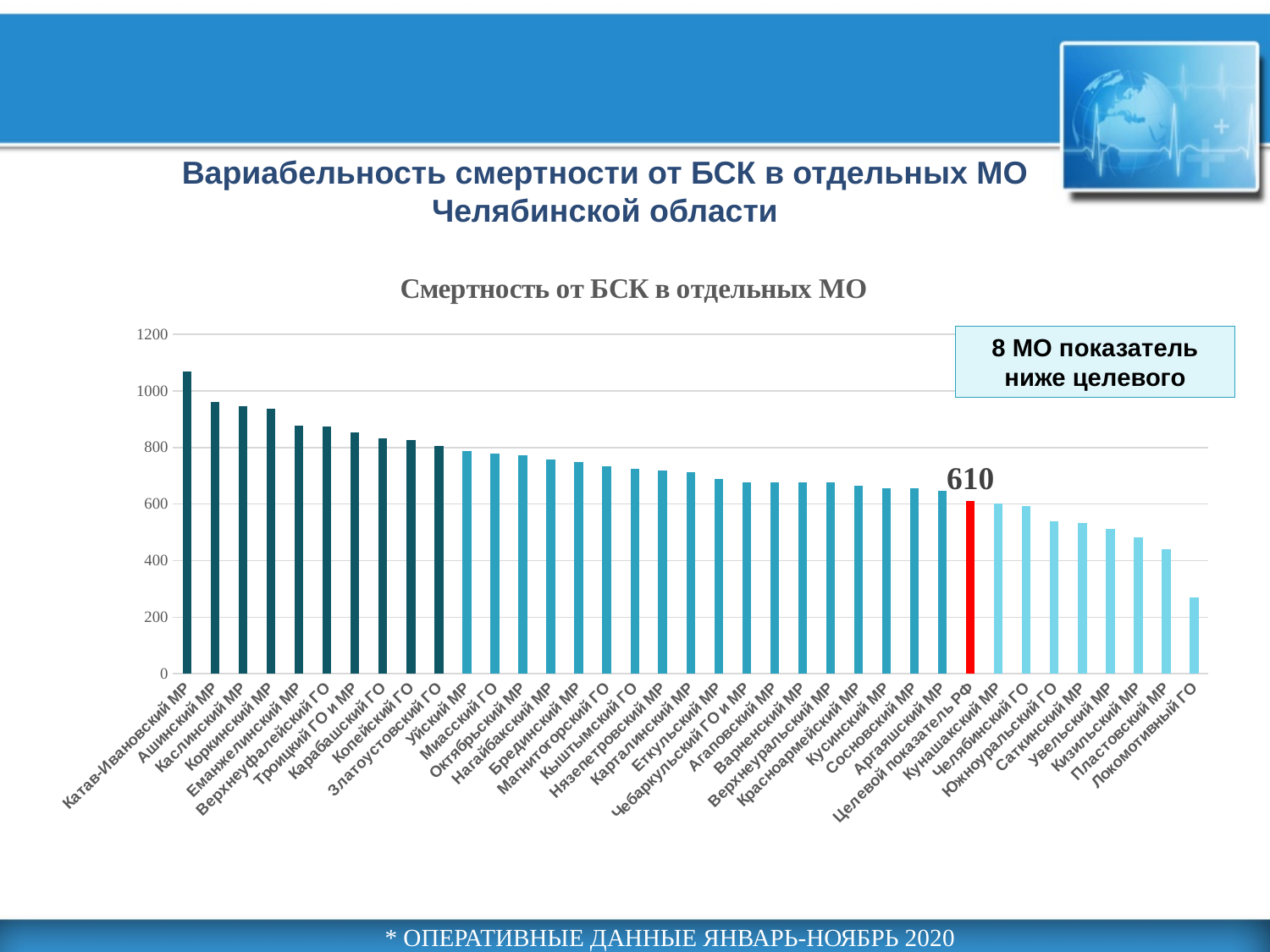
Which is larger, the value for Катав-Ивановский МР or the value for Ашинский МР? Катав-Ивановский МР Is the value for Еманжелинский МР greater or less than 800? greater Which category has the highest bar in the chart? Катав-Ивановский МР Is the value for Локомотивный ГО greater or less than 400? less Is the value for Саткинский МР greater or less than 600? less What kind of chart is shown on the slide? bar chart What value is printed on the bar for Целевой показатель РФ? 610 Which is larger, the value for Пластовский МР or the value for Локомотивный ГО? Пластовский МР Which category has the lowest bar in the chart? Локомотивный ГО According to the slide, how many МО have a value below the target? 8 Do the bar values rise or fall from left to right along the x axis? fall